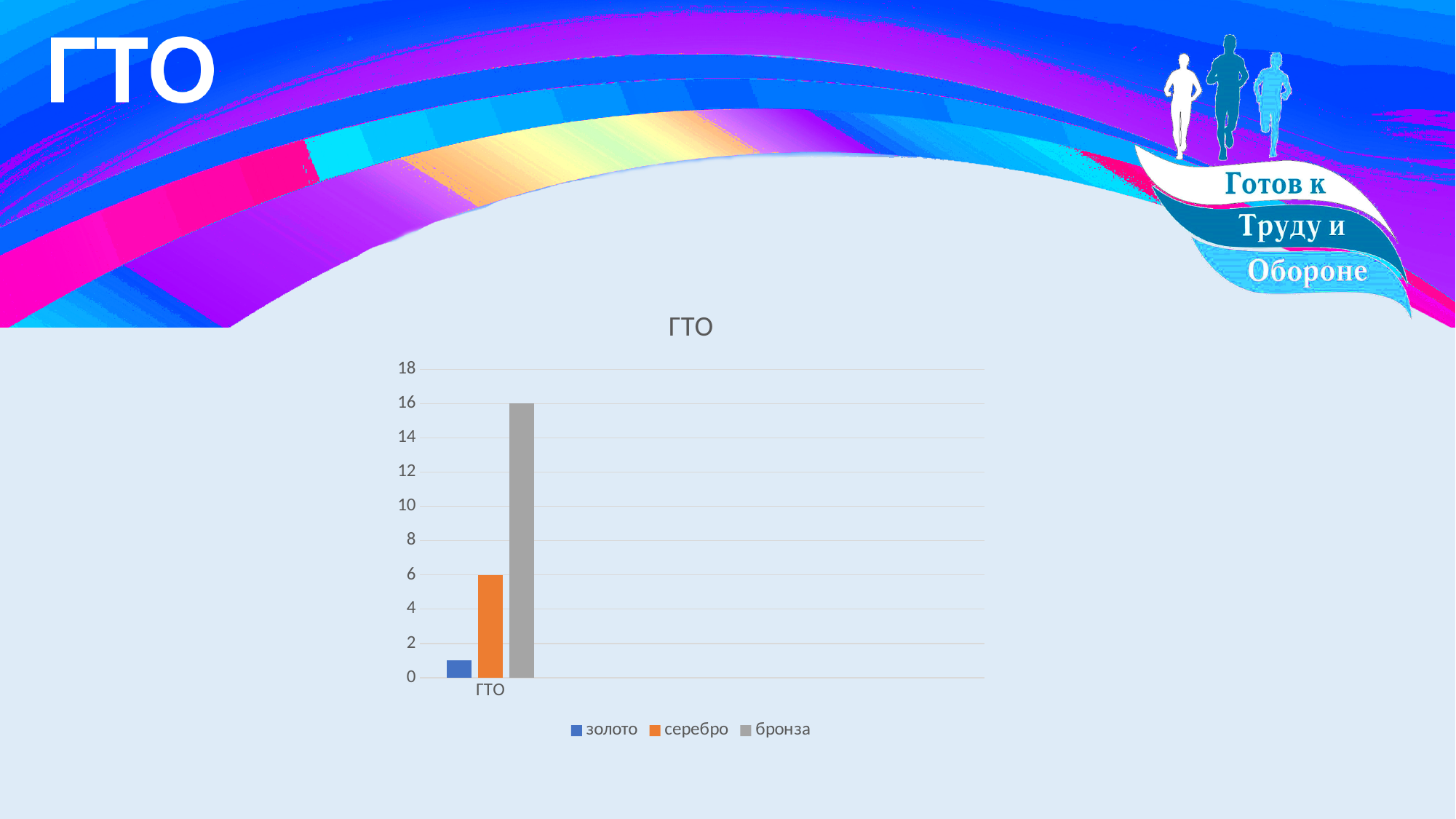
What kind of chart is shown on the slide? bar chart Is the value for золото greater or less than 2? less Which series has the lowest value? золото Which is larger, серебро or бронза? бронза How many categories are shown on the x axis? 1 What colour are the бронза bars? gray What is the difference between the values for бронза and серебро? 10 What is the title of the chart? ГТО How many series does the legend list? 3 What is the value for серебро? 6 What is the value for бронза? 16 Which series has the highest value? бронза